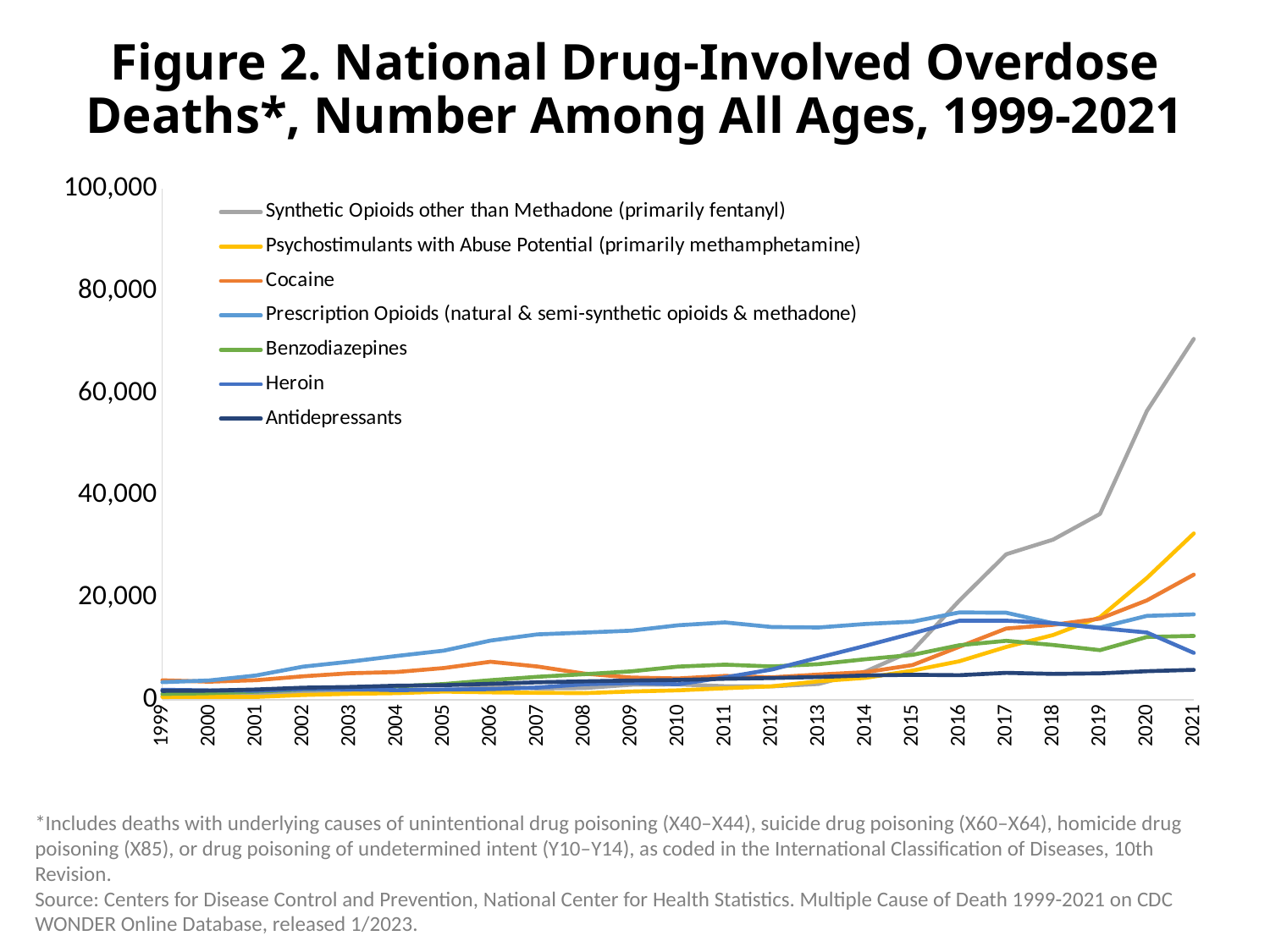
Is the value for Synthetic Opioids other than Methadone in 2019 greater or less than 40,000? less How many years are shown along the x axis? 23 How many series does the legend list? 7 What kind of chart is shown on the slide? Line chart What is the title of the chart? Figure 2. National Drug-Involved Overdose Deaths*, Number Among All Ages, 1999-2021 In 2021, which is larger: Psychostimulants with Abuse Potential or Cocaine? Psychostimulants with Abuse Potential Does the Synthetic Opioids other than Methadone line rise or fall from 2013 to 2021? Rise Is the value for Heroin in 2021 greater or less than 20,000? less Is the value for Psychostimulants with Abuse Potential in 2021 greater or less than 20,000? greater Which series has the highest value in 2021? Synthetic Opioids other than Methadone (primarily fentanyl) Which series has the lowest value in 2021? Antidepressants